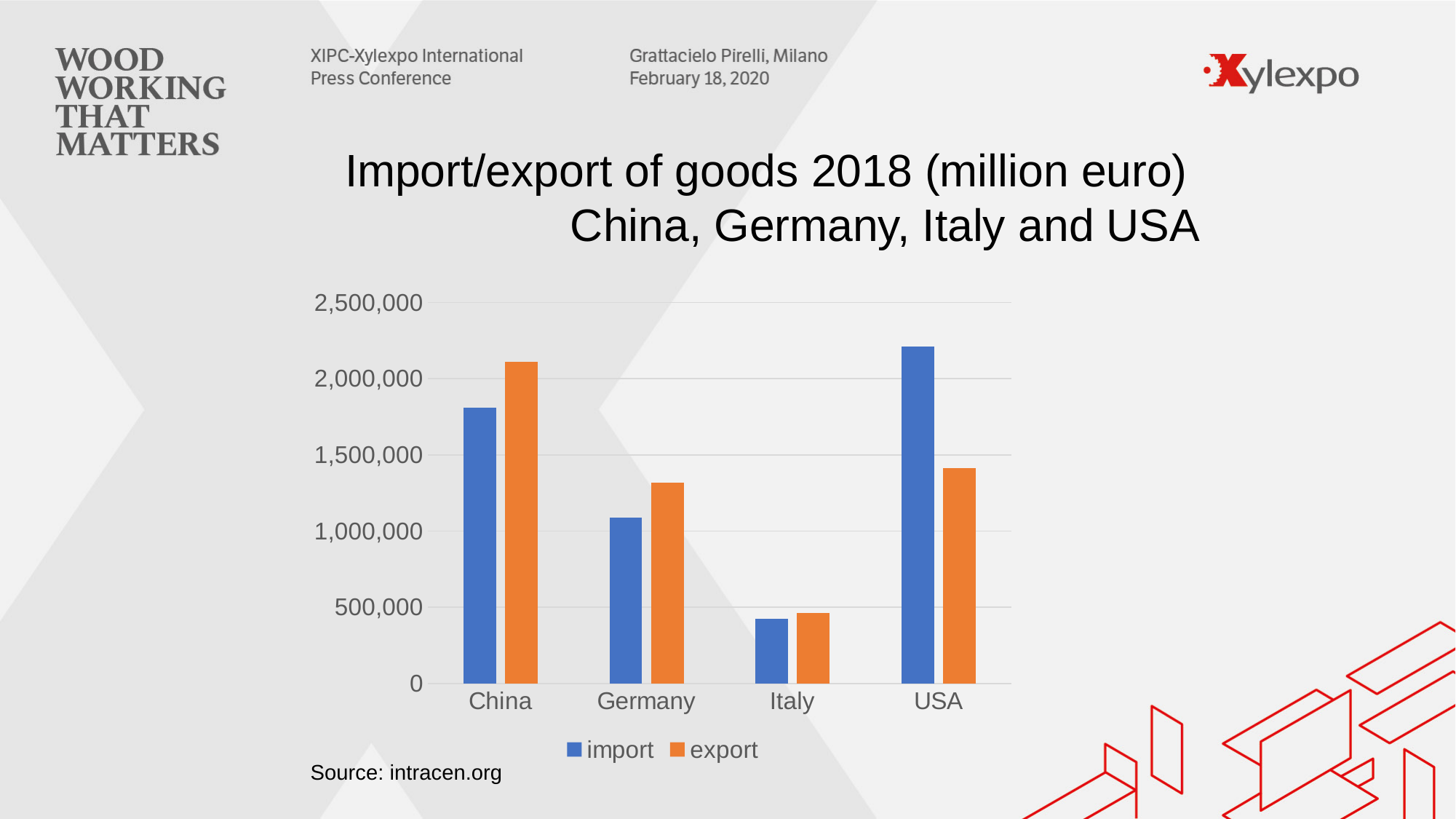
Is the import value for the USA greater or less than 2,000,000? greater Which country has the highest import value? USA For the USA, which is larger, import or export? import Is the export value for the USA greater or less than 1,500,000? less Which country has the highest export value? China How many series does the chart legend list? 2 What are the two entries in the chart legend? import and export Is the import value for Italy greater or less than 500,000? less What kind of chart is shown on the slide? bar chart For China, which is larger, import or export? export Which country has the lowest import value? Italy How many countries are shown on the x axis of the chart? 4